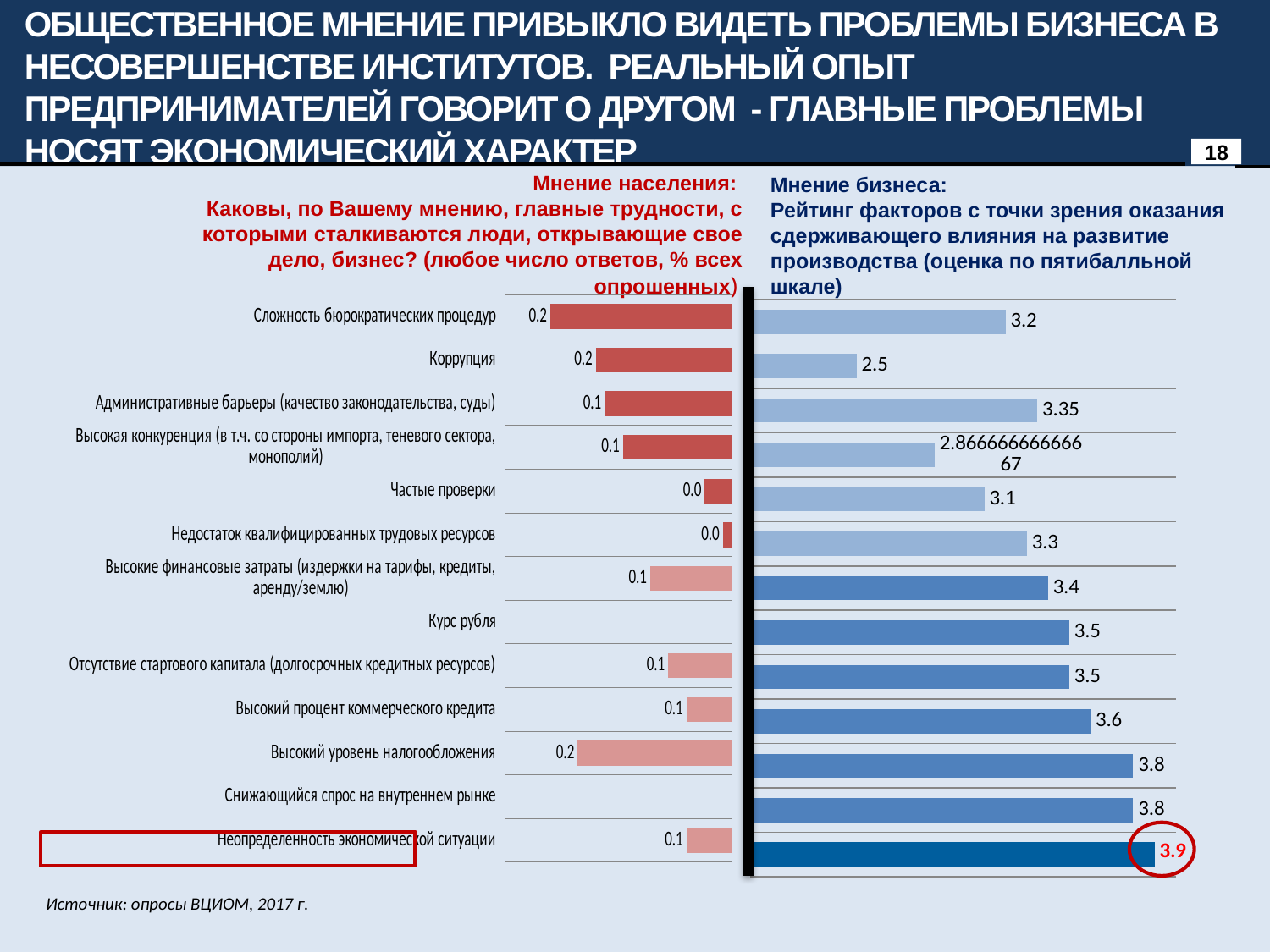
What type of chart is the 'Мнение бизнеса' chart? Bar chart How many categories are listed in the 'Мнение населения' chart? 13 In the 'Мнение бизнеса' chart, what is the difference between the values for 'Высокий уровень налогообложения' and 'Сложность бюрократических процедур'? 0.6 In the 'Мнение населения' chart, what is the value for 'Высокий уровень налогообложения'? 0.2 In the 'Мнение бизнеса' chart, which factor has the highest rating? Неопределенность экономической ситуации In the 'Мнение бизнеса' chart, what is the value for 'Неопределенность экономической ситуации'? 3.9 In the 'Мнение бизнеса' chart, which factor has the lowest rating? Коррупция In the 'Мнение бизнеса' chart, what is the value for 'Коррупция'? 2.5 In the 'Мнение населения' chart, what is the value for 'Частые проверки'? 0.0 In the 'Мнение бизнеса' chart, what is the value for 'Административные барьеры (качество законодательства, суды)'? 3.35 In the 'Мнение бизнеса' chart, which is larger: the value for 'Высокий процент коммерческого кредита' or the value for 'Частые проверки'? Высокий процент коммерческого кредита In the 'Мнение бизнеса' chart, which bar is circled in red? Неопределенность экономической ситуации (3.9)